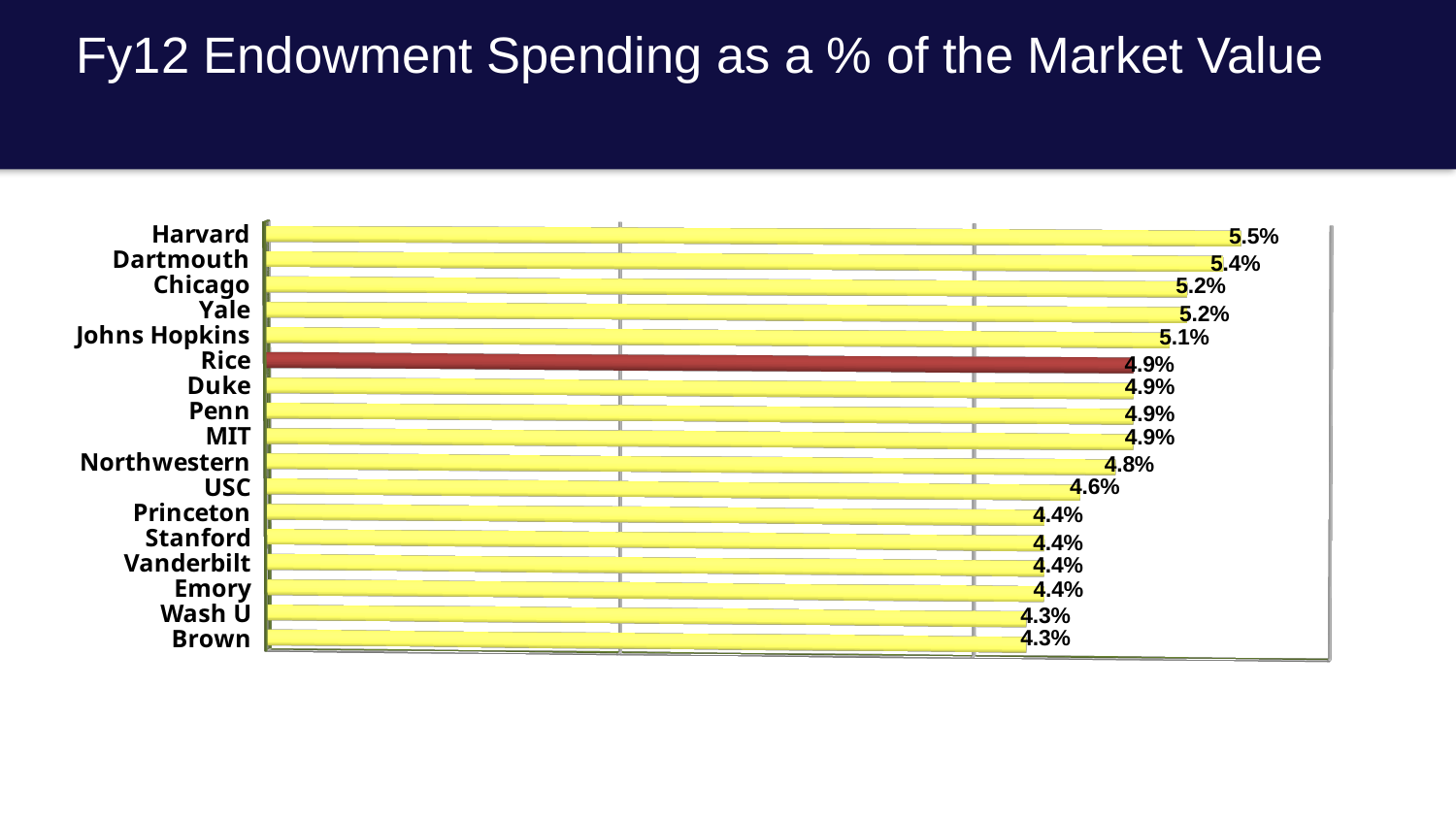
What kind of chart is shown on the slide? Bar chart What value is shown for Johns Hopkins? 5.1% Which has a higher value, Chicago or Stanford? Chicago What is the difference between Dartmouth's value and Rice's value? 0.5 percentage points Which institution's bar is highlighted in red? Rice What is the endowment spending as a % of market value for Rice? 4.9% Which institution has the highest endowment spending as a % of market value? Harvard Which has a higher value, Northwestern or Princeton? Northwestern How many institutions are shown in the chart? 17 What value is shown for USC? 4.6% What is the difference between Harvard's value and Brown's value? 1.2 percentage points What value is shown for Harvard? 5.5%